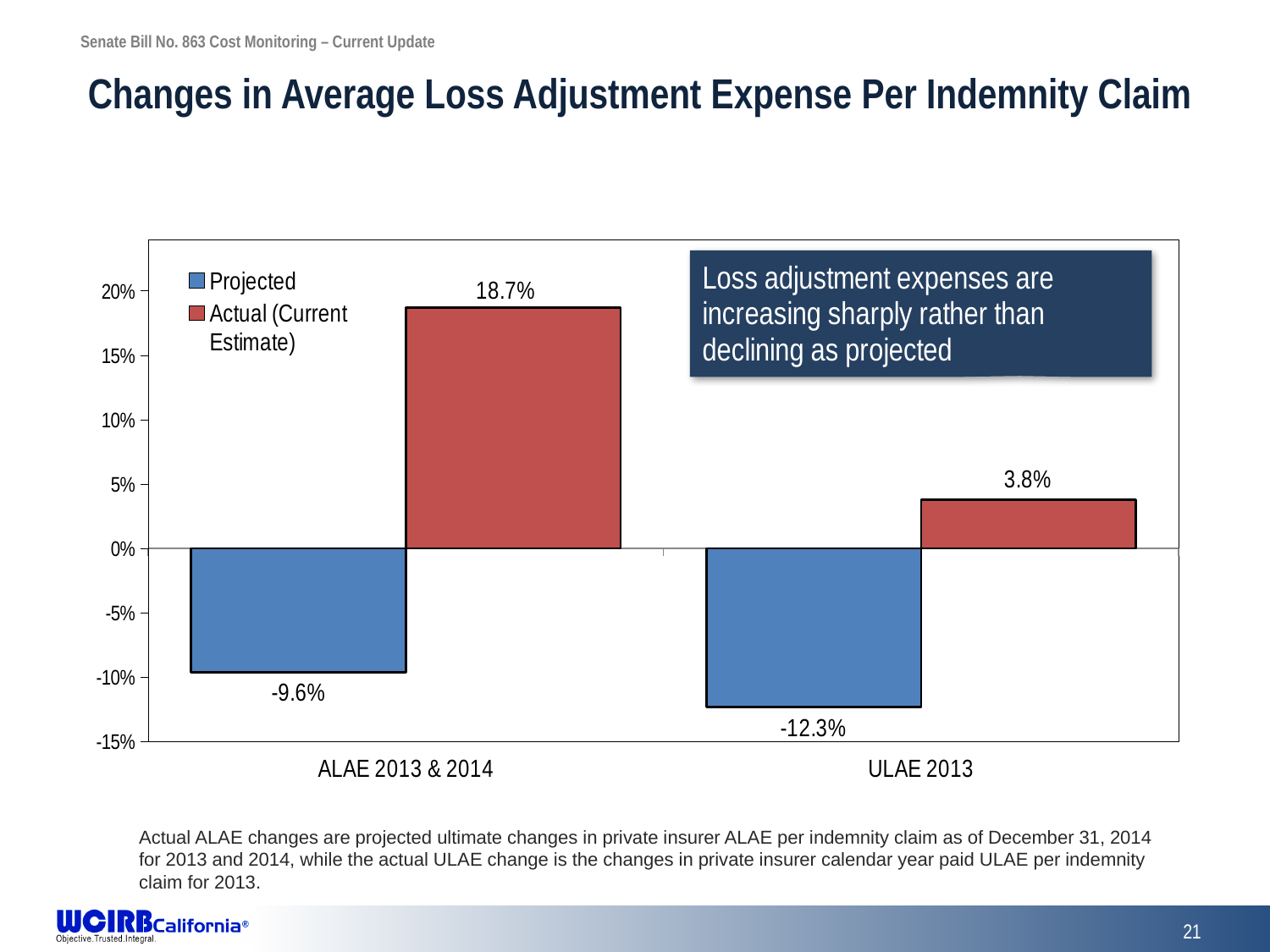
What is the difference between the Actual (Current Estimate) and Projected values for ALAE 2013 & 2014? 28.3 percentage points What is the Projected value for ULAE 2013? -12.3% Is the Actual (Current Estimate) value for ULAE 2013 larger or smaller than the Actual (Current Estimate) value for ALAE 2013 & 2014? smaller How many series does the legend list? 2 What kind of chart is shown on the slide? bar chart What is the Actual (Current Estimate) value for ALAE 2013 & 2014? 18.7% Which category has the lowest Projected value? ULAE 2013 Which category has the highest Actual (Current Estimate) value? ALAE 2013 & 2014 Which colour represents the Projected series? blue What is the Actual (Current Estimate) value for ULAE 2013? 3.8% What is the Projected value for ALAE 2013 & 2014? -9.6% How many categories are shown on the x axis? 2